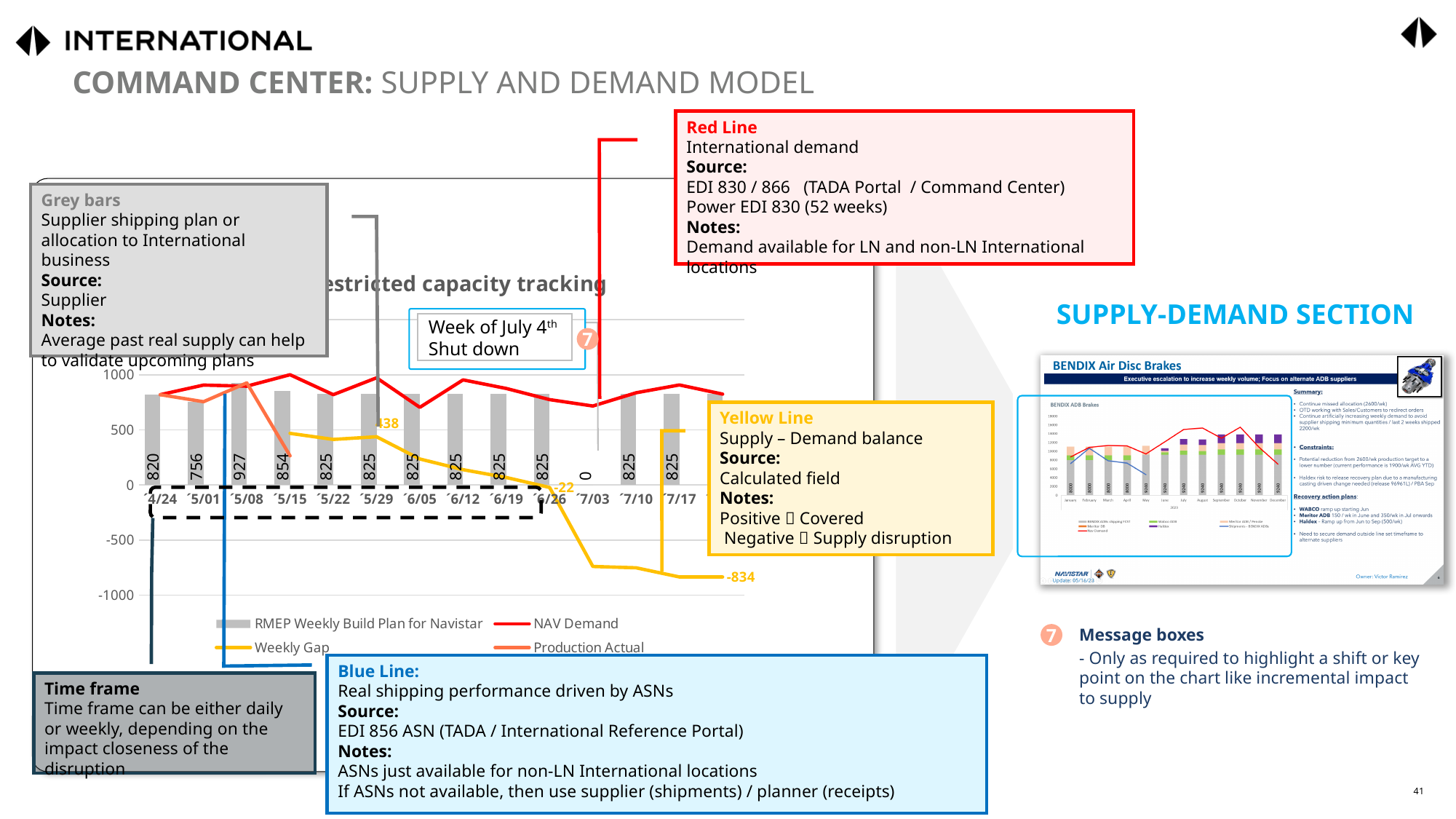
In the capacity tracking chart, what is the labelled Weekly Gap value at 5/29? 438 In the capacity tracking chart, what is the difference between the RMEP Weekly Build Plan bars for 5/08 and 5/01? 171 In the capacity tracking chart, is the NAV Demand value at 7/03 greater or less than 500? greater In the capacity tracking chart, what is the RMEP Weekly Build Plan for Navistar value for the week of 4/24? 820 How many series does the legend of the capacity tracking chart list? 4 In the capacity tracking chart, which week has the highest RMEP Weekly Build Plan for Navistar bar? 5/08 In the capacity tracking chart, which week has the lowest RMEP Weekly Build Plan for Navistar bar? 7/03 In the capacity tracking chart, which is larger: the RMEP Weekly Build Plan bar for 4/24 or for 5/01? 4/24 In the capacity tracking chart, what is the RMEP Weekly Build Plan for Navistar value for the week of 5/01? 756 In the capacity tracking chart, what is the RMEP Weekly Build Plan for Navistar value for the week of 7/03? 0 In the capacity tracking chart, what colour is the NAV Demand line? Red In the capacity tracking chart, what is the labelled Weekly Gap value at 7/17? -834